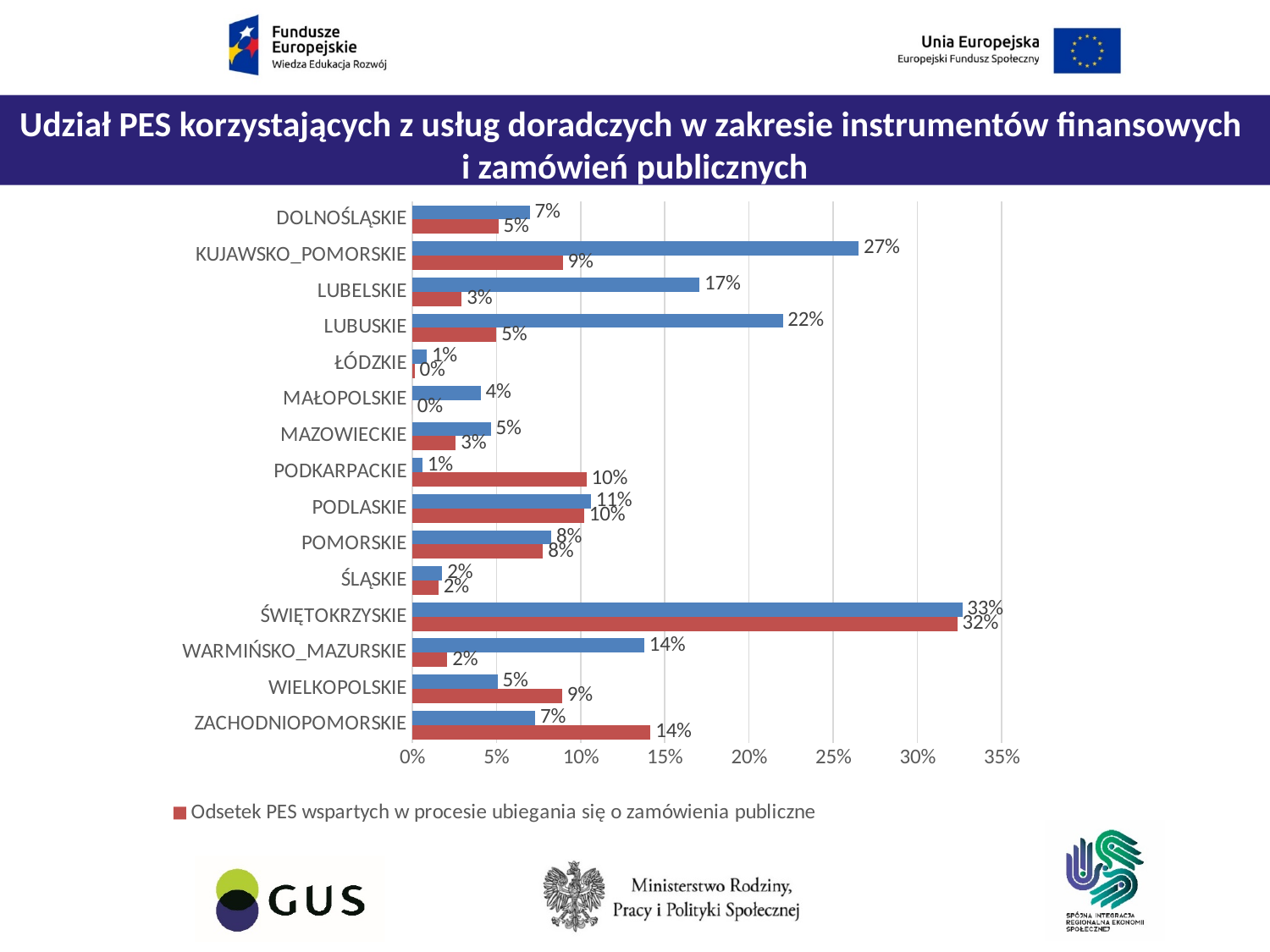
Which voivodeship has the highest value in the blue series? ŚWIĘTOKRZYSKIE Is the blue series value for LUBELSKIE greater or less than 15%? greater What is the difference between the blue series value and the red series value for LUBUSKIE? 17% For WARMIŃSKO_MAZURSKIE, which is larger: the blue series value or the red series value? the blue series value What is the maximum value shown on the horizontal axis? 35% What type of chart is shown on the slide? bar chart What is the value of 'Odsetek PES wspartych w procesie ubiegania się o zamówienia publiczne' (red series) for ZACHODNIOPOMORSKIE? 14% What is the value of the red series (zamówienia publiczne) for MAŁOPOLSKIE? 0% What is the value of the blue series for KUJAWSKO_POMORSKIE? 27% What is the value of the red series (zamówienia publiczne) for PODKARPACKIE? 10% Which voivodeship has the highest value in the red series (zamówienia publiczne)? ŚWIĘTOKRZYSKIE How many voivodeships (categories) are listed on the chart? 15